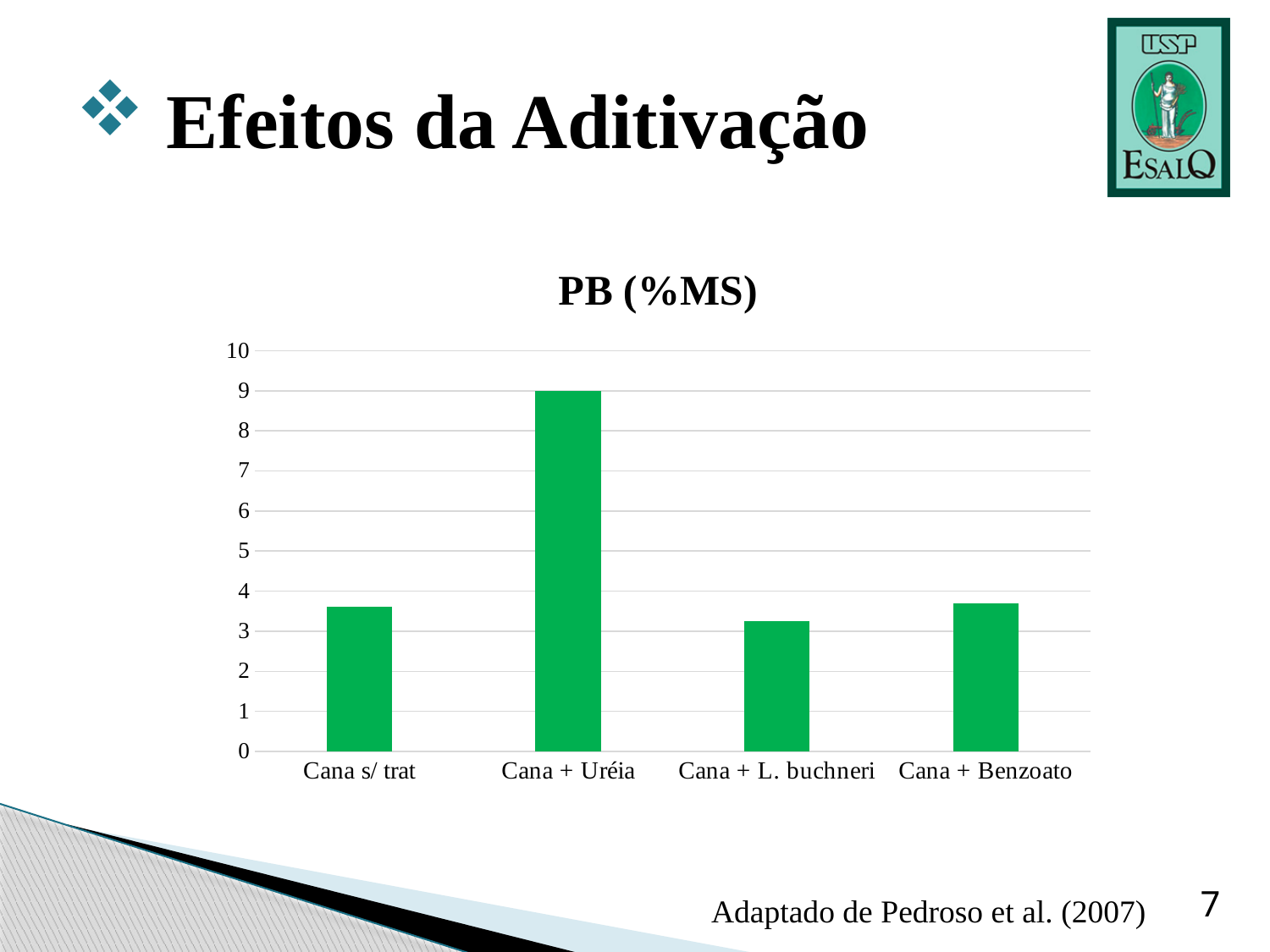
How many categories are shown on the x axis of the chart? 4 Is the value for Cana + Uréia greater or less than 8? greater Is the value for Cana + Benzoato greater or less than 4? less Which category has the lowest value in the chart? Cana + L. buchneri Which is larger, the value for Cana s/ trat or the value for Cana + L. buchneri? Cana s/ trat Is the value for Cana + L. buchneri greater or less than 3? greater Which category has the highest value in the chart? Cana + Uréia Which is larger, the value for Cana + Uréia or the value for Cana + Benzoato? Cana + Uréia What kind of chart is shown on the slide? bar chart What is the value for Cana + Uréia? 9 What is the title of the chart? PB (%MS)